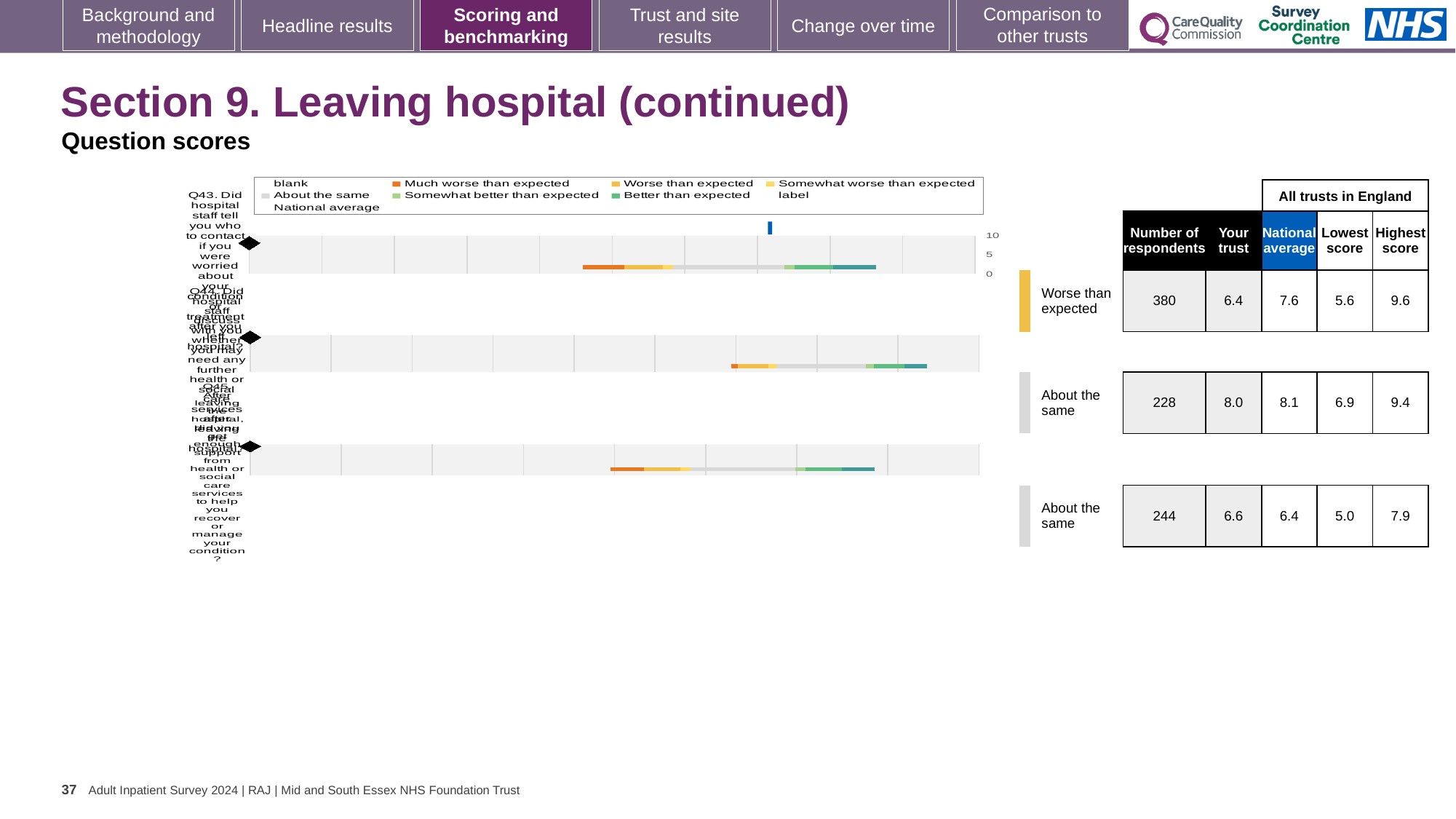
Which legend entry is shown in dark orange in the chart legend? Much worse than expected For the top chart (Q43), what benchmark category is the trust's score given? Worse than expected Which legend entry is shown in dark green in the chart legend? Better than expected For the bottom chart, how many respondents are shown in the table? 244 What kind of chart is used to show the question scores on this slide? bar chart For the top chart (Q43), what is the difference between the national average and the 'Your trust' score? 1.2 For the middle chart, what is the 'Your trust' score shown in the table? 8.0 For the top chart (Q43), what is the national average shown in the table? 7.6 How many question score charts are shown on the slide? 3 For the middle chart, what is the highest score across all trusts in England? 9.4 For the top chart (Q43), what is the 'Your trust' score shown in the table? 6.4 For the bottom chart, is the 'Your trust' score larger or smaller than the national average? larger